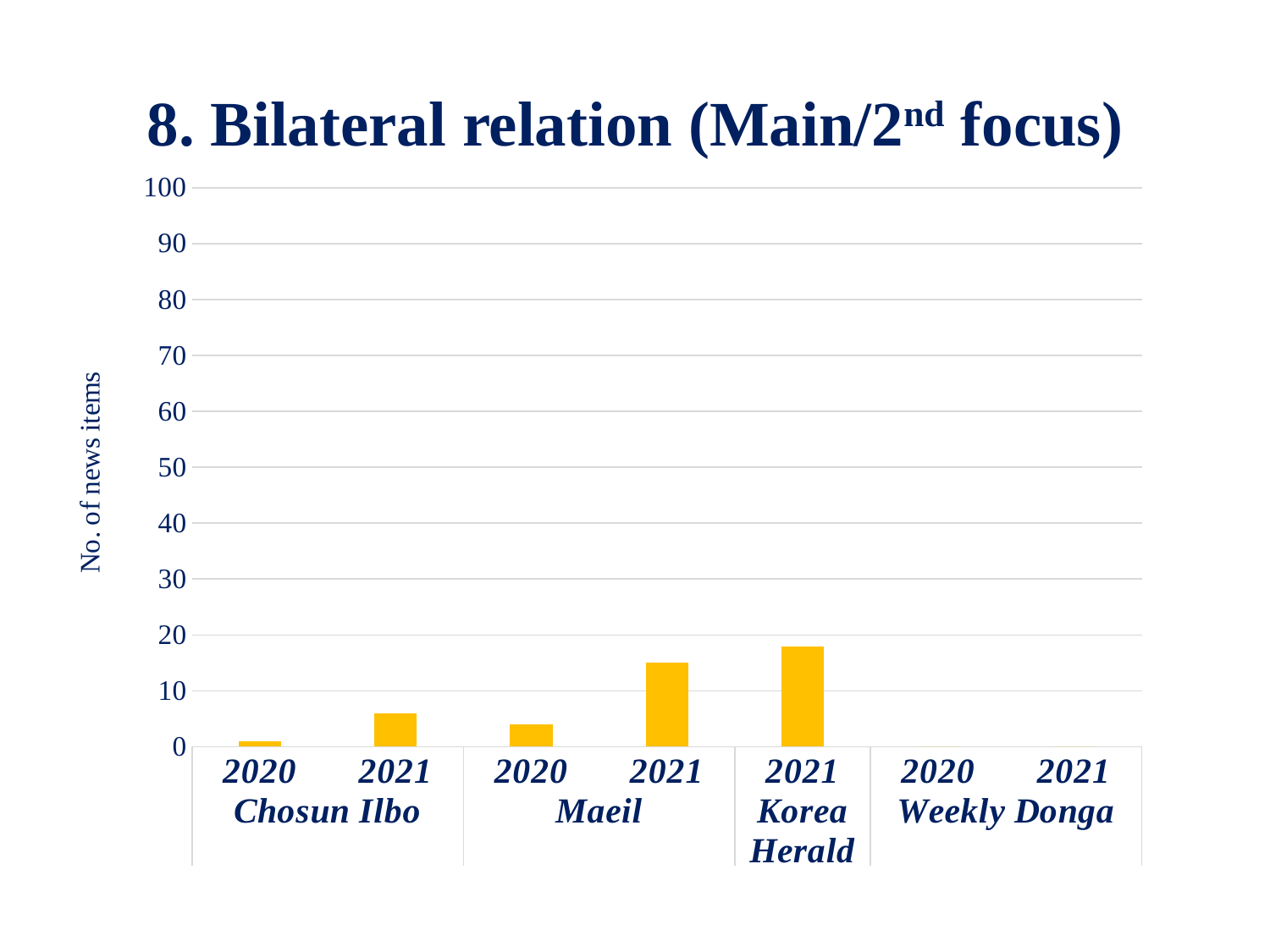
What kind of chart is shown on the slide? bar chart Is the value for Maeil 2021 greater or less than 10? greater What is the title of the slide containing the chart? 8. Bilateral relation (Main/2nd focus) Is the value for Korea Herald 2021 greater or less than 10? greater For Maeil, does the value rise or fall from 2020 to 2021? rise Is the value for Chosun Ilbo 2021 greater or less than 10? less Which is larger, the value for Maeil 2021 or the value for Chosun Ilbo 2021? Maeil 2021 How many newspapers are shown along the x axis? 4 What is the label of the vertical axis? No. of news items Which is larger, the value for Maeil 2020 or the value for Chosun Ilbo 2020? Maeil 2020 Which bar is the highest in the chart? Korea Herald 2021